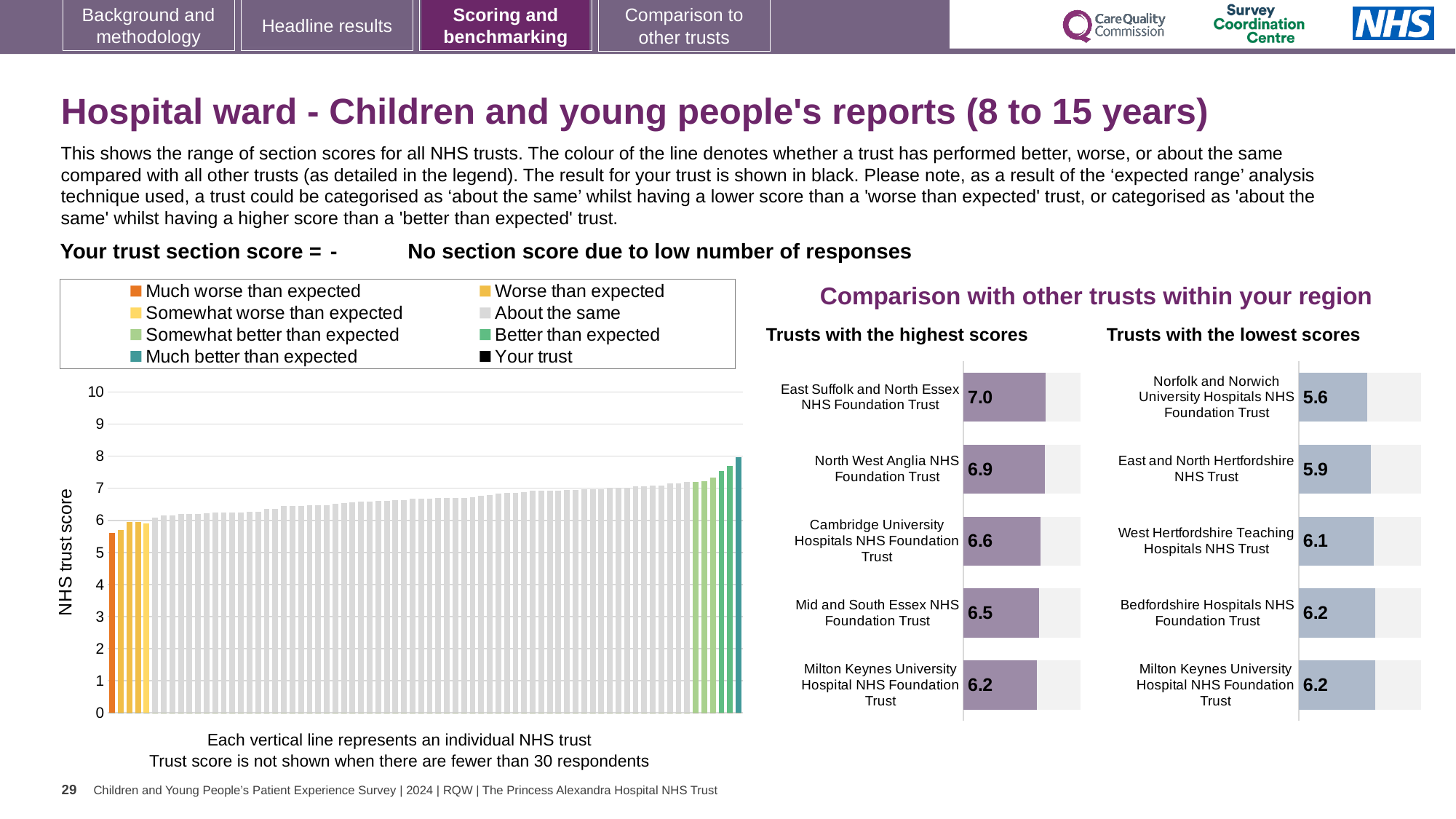
In the 'Trusts with the highest scores' chart, what is the difference between the scores of East Suffolk and North Essex NHS Foundation Trust and Cambridge University Hospitals NHS Foundation Trust? 0.4 What type of chart is the large chart on the left showing NHS trust scores? Bar chart In the large chart on the left, do the NHS trust scores rise or fall from left to right? Rise In the large chart on the left, is the value of the leftmost (orange) bar greater or less than 6? less How many trusts are shown in the 'Trusts with the highest scores' chart? 5 In the 'Trusts with the highest scores' chart, what is the score for North West Anglia NHS Foundation Trust? 6.9 In the 'Trusts with the highest scores' chart, which trust has the lowest score? Milton Keynes University Hospital NHS Foundation Trust In the 'Trusts with the lowest scores' chart, which trust has the lowest score? Norfolk and Norwich University Hospitals NHS Foundation Trust In the 'Trusts with the lowest scores' chart, which has the higher score: East and North Hertfordshire NHS Trust or West Hertfordshire Teaching Hospitals NHS Trust? West Hertfordshire Teaching Hospitals NHS Trust How many entries does the legend of the large chart on the left list? 8 In the 'Trusts with the highest scores' chart, what is the score for East Suffolk and North Essex NHS Foundation Trust? 7.0 In the 'Trusts with the lowest scores' chart, what is the score for Norfolk and Norwich University Hospitals NHS Foundation Trust? 5.6